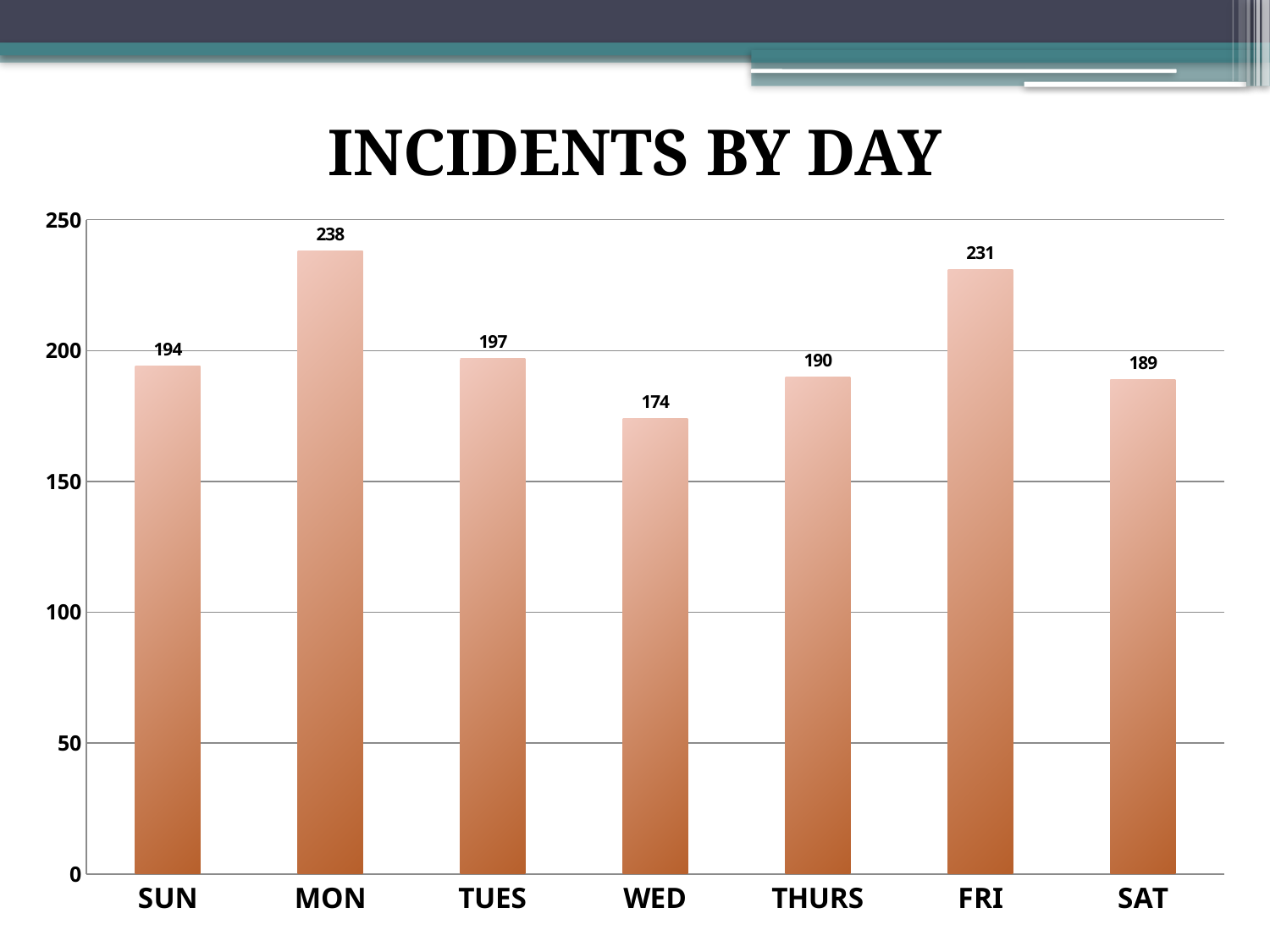
What is the value for FRI? 231 What is the difference between the values for MON and WED? 64 Which day has the highest number of incidents? MON Is the value for THURS greater or less than 200? less Which is larger, the value for SUN or the value for TUES? TUES What is the difference between the values for FRI and SAT? 42 What is the value for MON? 238 How many days are shown on the x axis? 7 What is the value for WED? 174 What kind of chart is shown on the slide? bar chart What is the title of the chart? INCIDENTS BY DAY Which day has the lowest number of incidents? WED